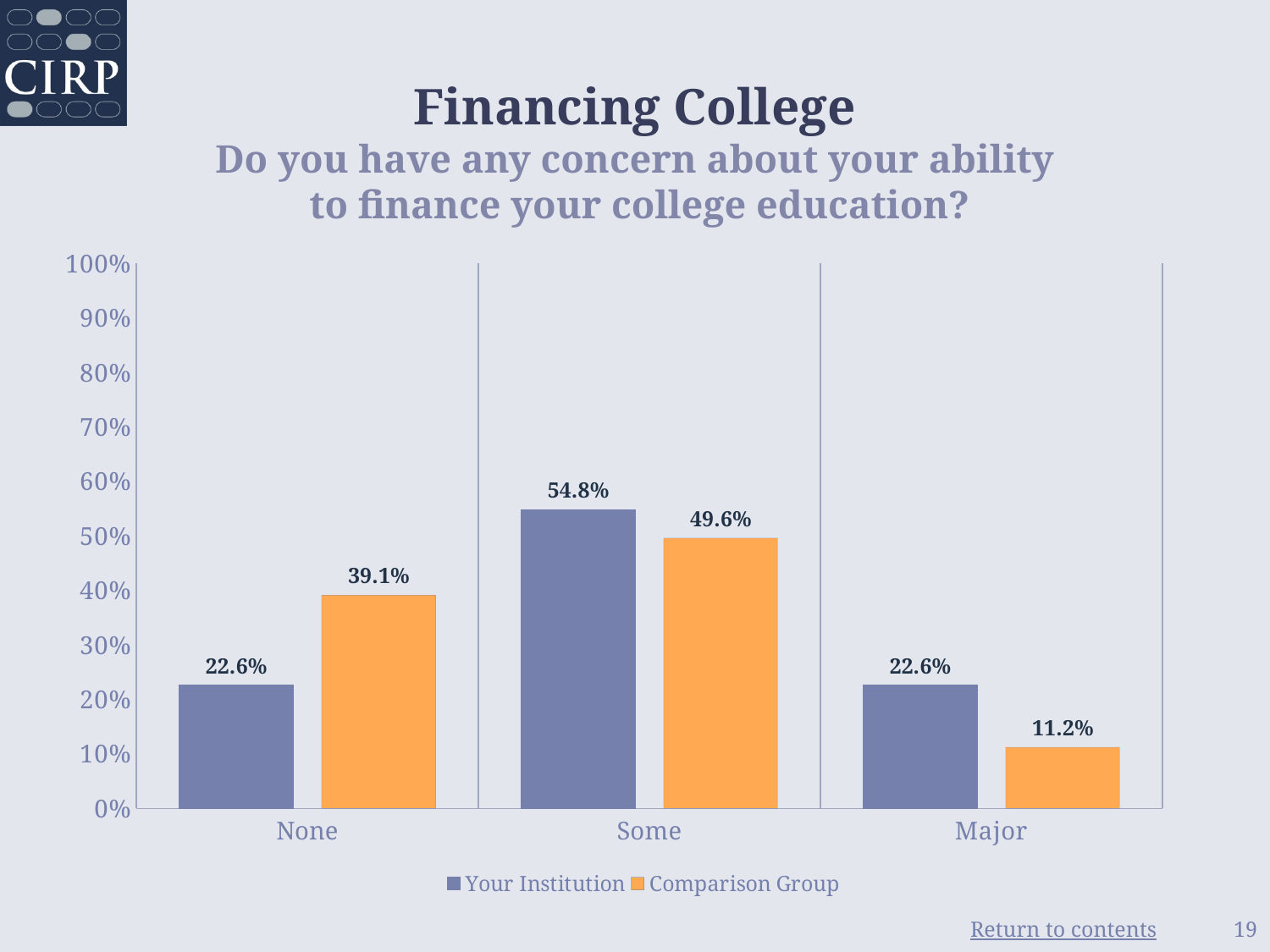
Which category has the lowest value for Comparison Group? Major How many categories are shown on the x axis? 3 What is the value for Comparison Group in the Major category? 11.2% What is the value for Comparison Group in the Some category? 49.6% In the Some category, which is larger: Your Institution or Comparison Group? Your Institution How many series does the legend list? 2 Which category has the highest value for Your Institution? Some What is the value for Your Institution in the None category? 22.6% What kind of chart is shown on the slide? Bar chart What is the difference between Comparison Group and Your Institution in the None category? 16.5% Is the value for Comparison Group in the None category greater or less than 30%? greater What is the difference between Your Institution and Comparison Group in the Major category? 11.4%